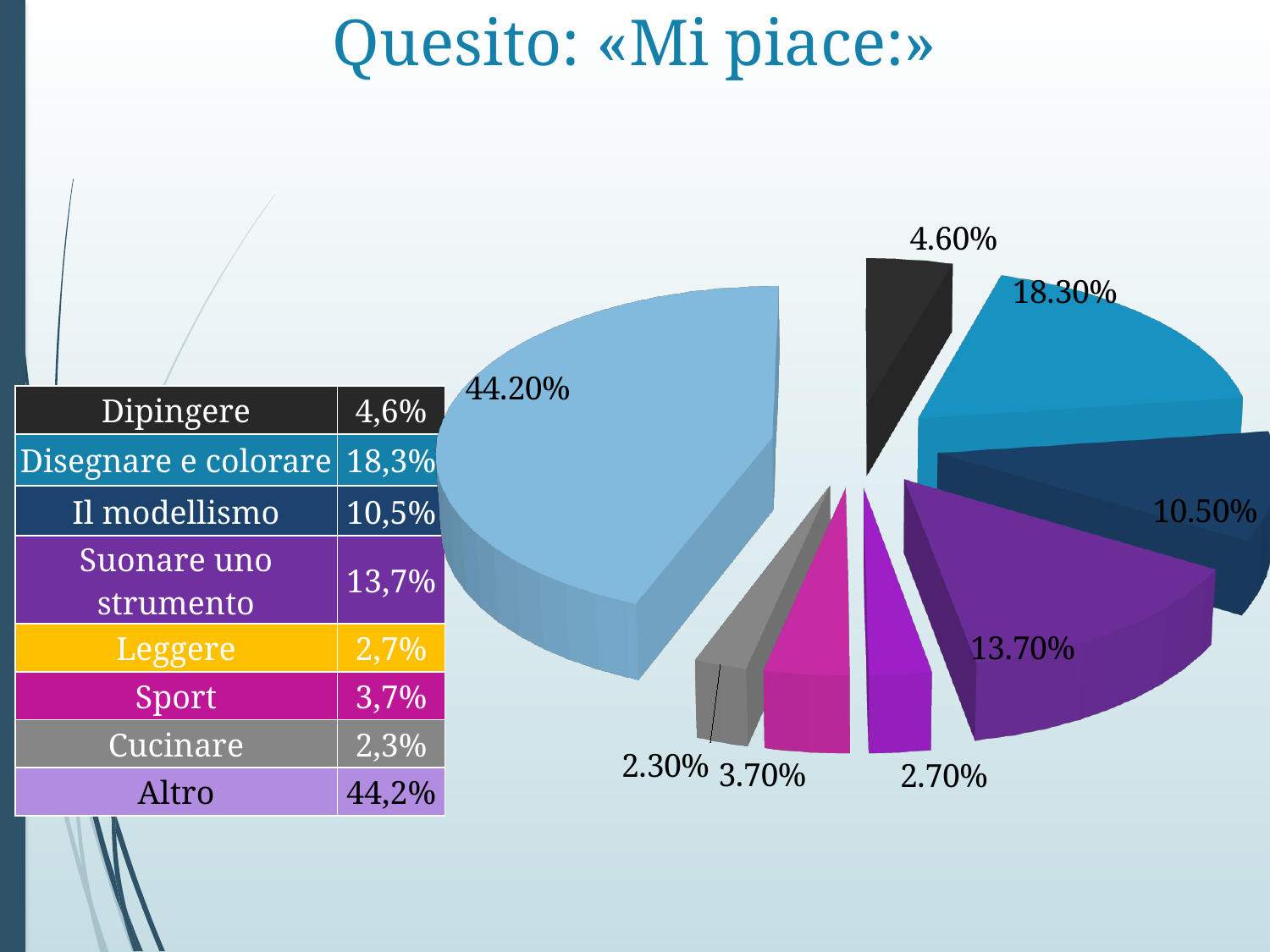
What kind of chart is shown on the slide? pie chart What percentage does the pie chart show for Il modellismo? 10.50% What percentage is shown for the largest slice of the pie chart? 44.20% What percentage does the pie chart show for Disegnare e colorare? 18.30% What is the title of the slide containing the pie chart? Quesito: «Mi piace:» What share of the pie does Dipingere represent? 4.60% What is the difference in percentage points between Disegnare e colorare and Il modellismo? 7.80% What percentage does the pie chart show for Suonare uno strumento? 13.70% Which category has the smallest slice of the pie chart? Cucinare Which has a larger share of the pie, Sport or Leggere? Sport How many slices does the pie chart have? 8 Which category has the largest slice of the pie chart? Altro